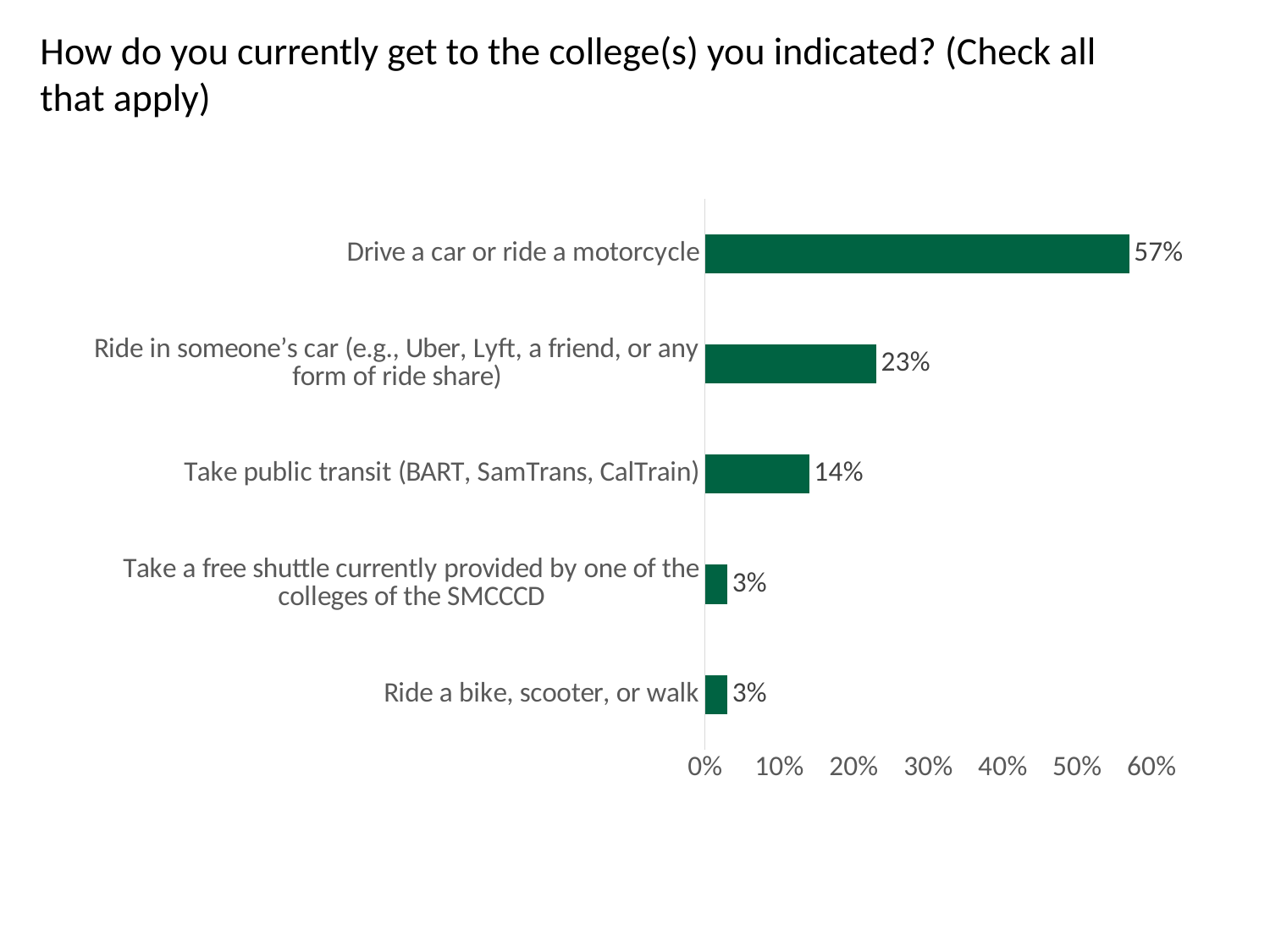
What percentage of respondents drive a car or ride a motorcycle? 57% What percentage of respondents take a free shuttle currently provided by one of the colleges of the SMCCCD? 3% What kind of chart is shown on the slide? Bar chart What percentage of respondents take public transit (BART, SamTrans, CalTrain)? 14% How many transportation categories are shown in the chart? 5 What is the difference in percentage points between driving a car or riding a motorcycle and riding in someone's car? 34% What is the difference in percentage points between riding in someone's car and taking public transit? 9% What percentage of respondents ride in someone's car (e.g., Uber, Lyft, a friend, or any form of ride share)? 23% Which is larger: the percentage who take public transit or the percentage who ride a bike, scooter, or walk? Take public transit (BART, SamTrans, CalTrain) Which mode of getting to college has the highest percentage? Drive a car or ride a motorcycle What is the highest value shown on the x axis of the chart? 60% Is the value for 'Drive a car or ride a motorcycle' greater or less than 50%? greater